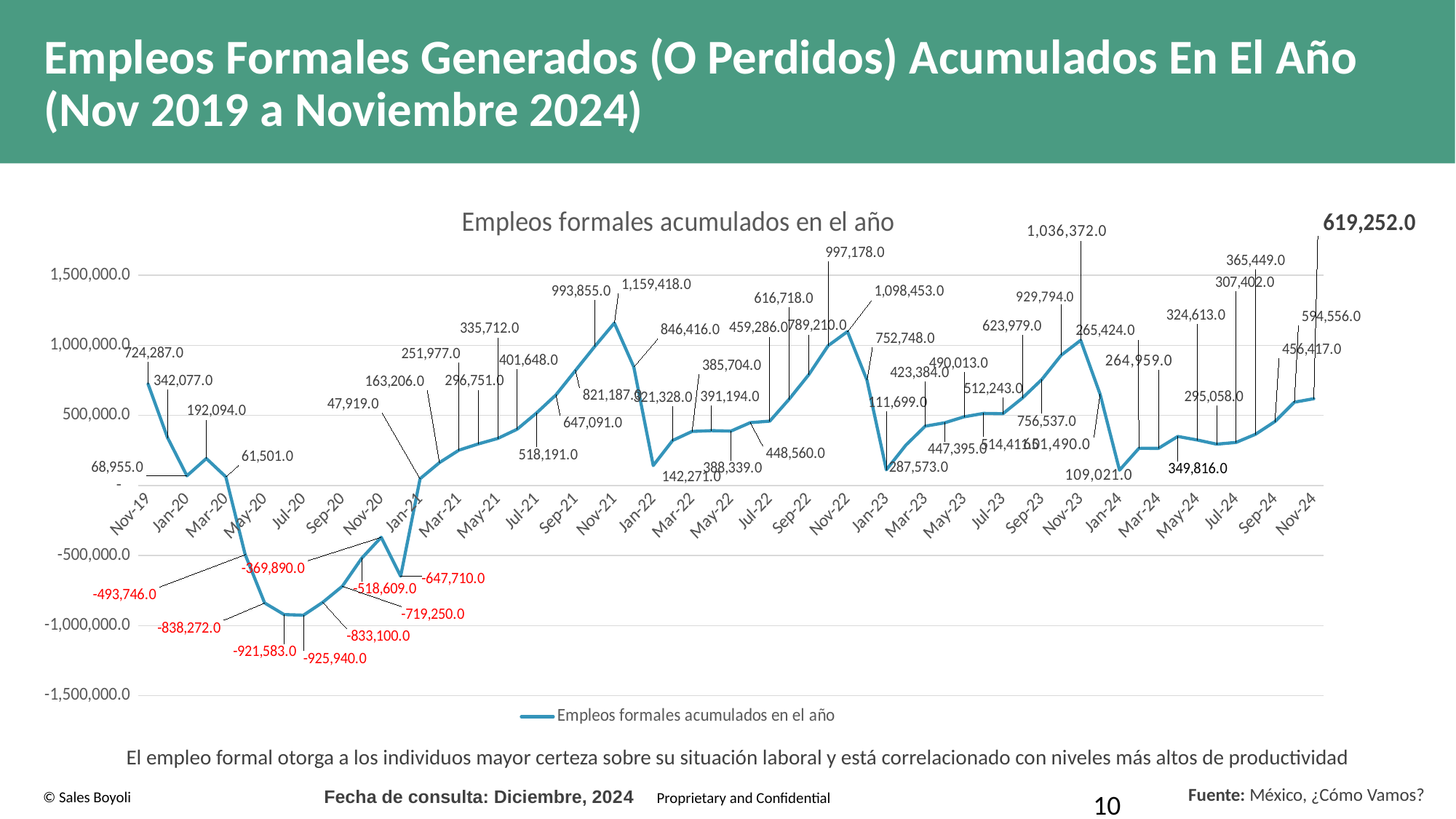
What is the title of the chart? Empleos formales acumulados en el año Do the values rise or fall from Jan-24 to Nov-24? rise What is the lowest value plotted on the chart? -925,940.0 What is the value for Nov-24, the last point on the chart? 619,252.0 What kind of chart is shown on the slide? line chart Is the value for Jan-22 greater or less than 500,000.0? less Which is larger, the value for Nov-21 or the value for Nov-24? Nov-21 What is the difference between the value for Nov-19 (724,287.0) and the value for Nov-24 (619,252.0)? 105,035.0 What is the highest value plotted on the chart? 1,159,418.0 Do the values rise or fall from Mar-20 to Jul-20? fall How many series does the chart legend list? 1 What is the value for Nov-19, the first point on the chart? 724,287.0